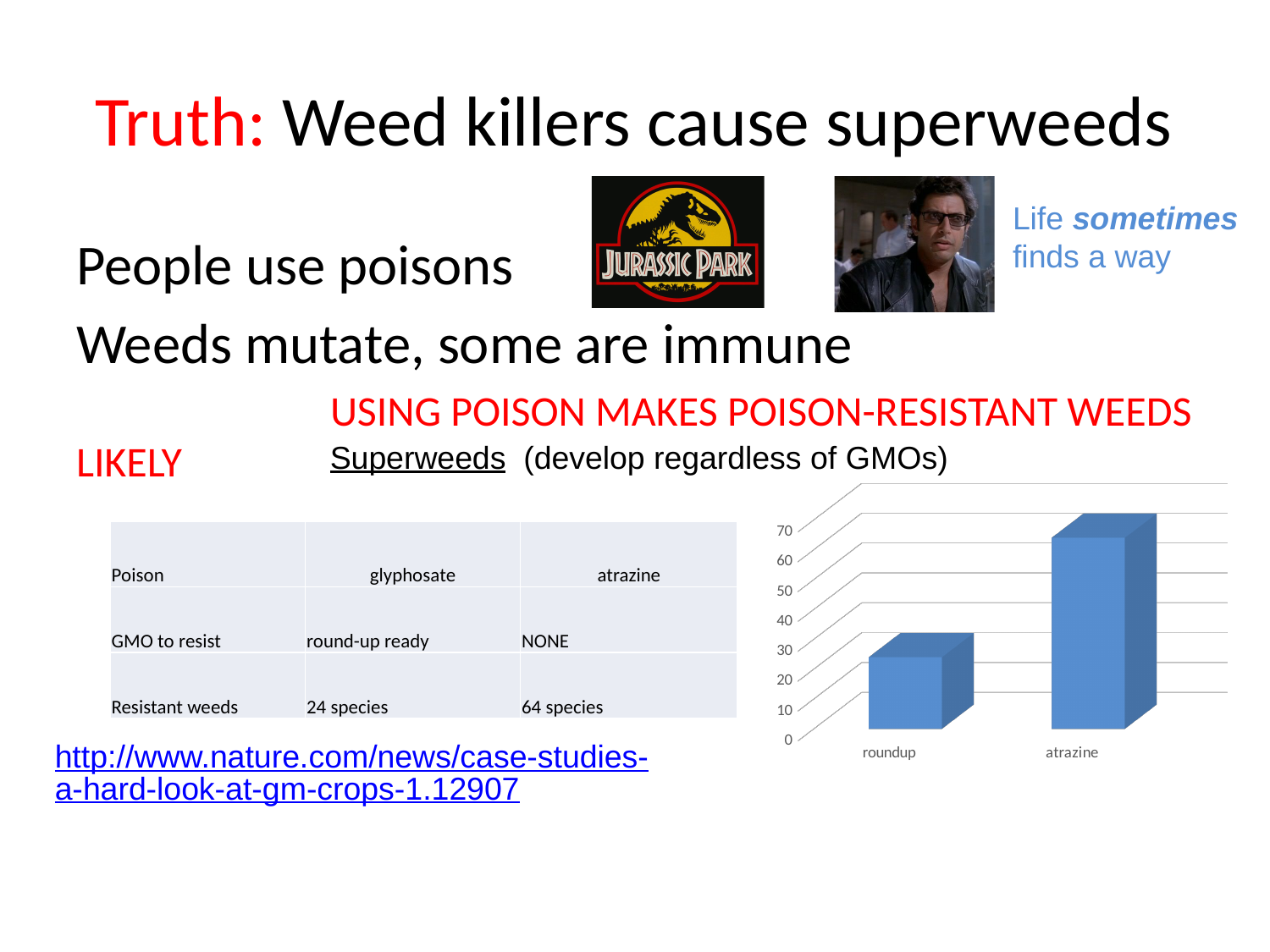
What kind of chart is shown on the slide? bar chart Which is larger in the chart, the value for roundup or the value for atrazine? atrazine Which category has the highest bar in the chart? atrazine What colour are the bars in the chart? blue Is the value for atrazine greater or less than 60? greater Do the bar values rise or fall from left to right along the x axis? rise Is the value for roundup greater or less than 20? greater What is the highest tick value shown on the vertical axis of the chart? 70 How many categories are shown on the x axis of the chart? 2 Which category has the lowest bar in the chart? roundup